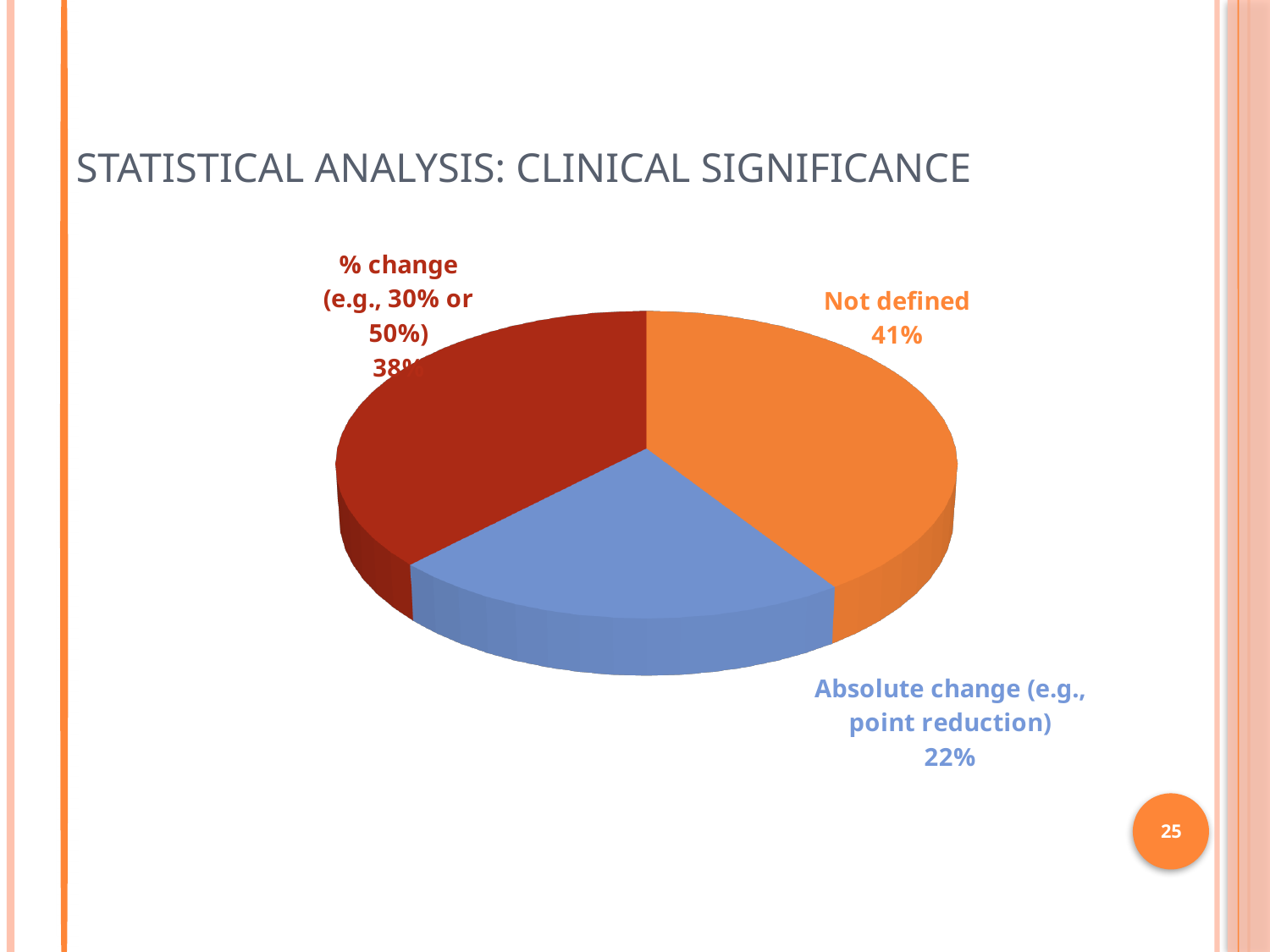
What share of the pie is labelled "Not defined"? 41% What kind of chart is shown on the slide? pie chart What share of the pie is labelled "% change (e.g., 30% or 50%)"? 38% What share of the pie is labelled "Absolute change (e.g., point reduction)"? 22% What is the title of the slide containing the pie chart? STATISTICAL ANALYSIS: CLINICAL SIGNIFICANCE Which is larger, the "Not defined" slice or the "Absolute change (e.g., point reduction)" slice? Not defined How many slices does the pie chart have? 3 What is the difference in percentage points between the "Not defined" slice and the "Absolute change (e.g., point reduction)" slice? 19 What is the difference in percentage points between the "% change (e.g., 30% or 50%)" slice and the "Absolute change (e.g., point reduction)" slice? 16 What colour is the "Not defined" slice of the pie chart? orange Which slice of the pie is the smallest? Absolute change (e.g., point reduction) Which slice of the pie is the largest? Not defined